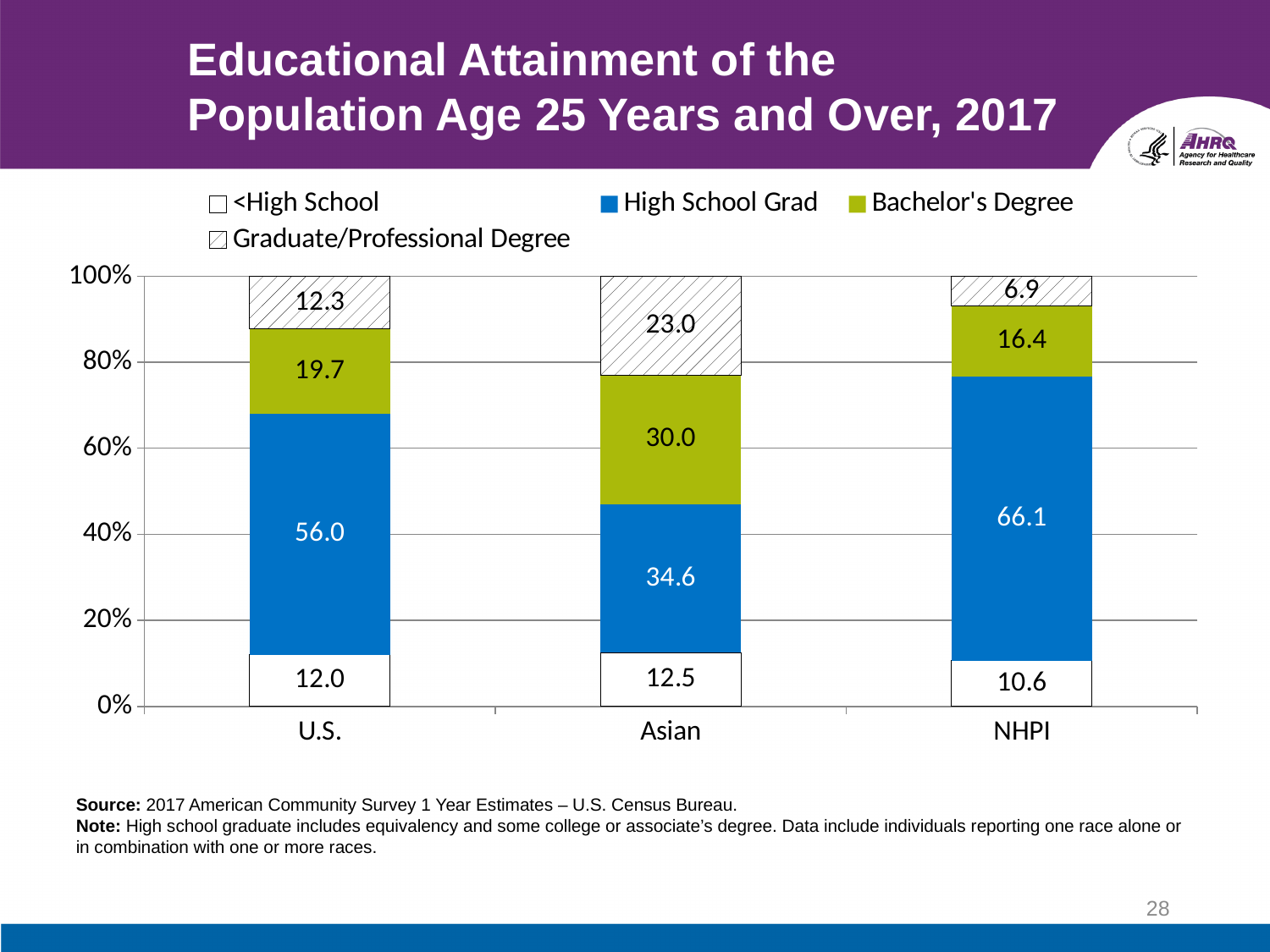
What kind of chart is shown? Stacked bar chart What is the <High School value for NHPI? 10.6 What is the Graduate/Professional Degree value for the U.S.? 12.3 What is the High School Grad value for NHPI? 66.1 What is the total of the stacked bar for Asian? 100.1 What is the Bachelor's Degree value for Asian? 30.0 How many series does the legend list? 4 What is the difference between the Bachelor's Degree values for Asian and NHPI? 13.6 Which is larger, the High School Grad value for the U.S. or for NHPI? NHPI Which group has the highest Graduate/Professional Degree value? Asian Which group has the lowest High School Grad value? Asian How many groups are shown on the x axis? 3